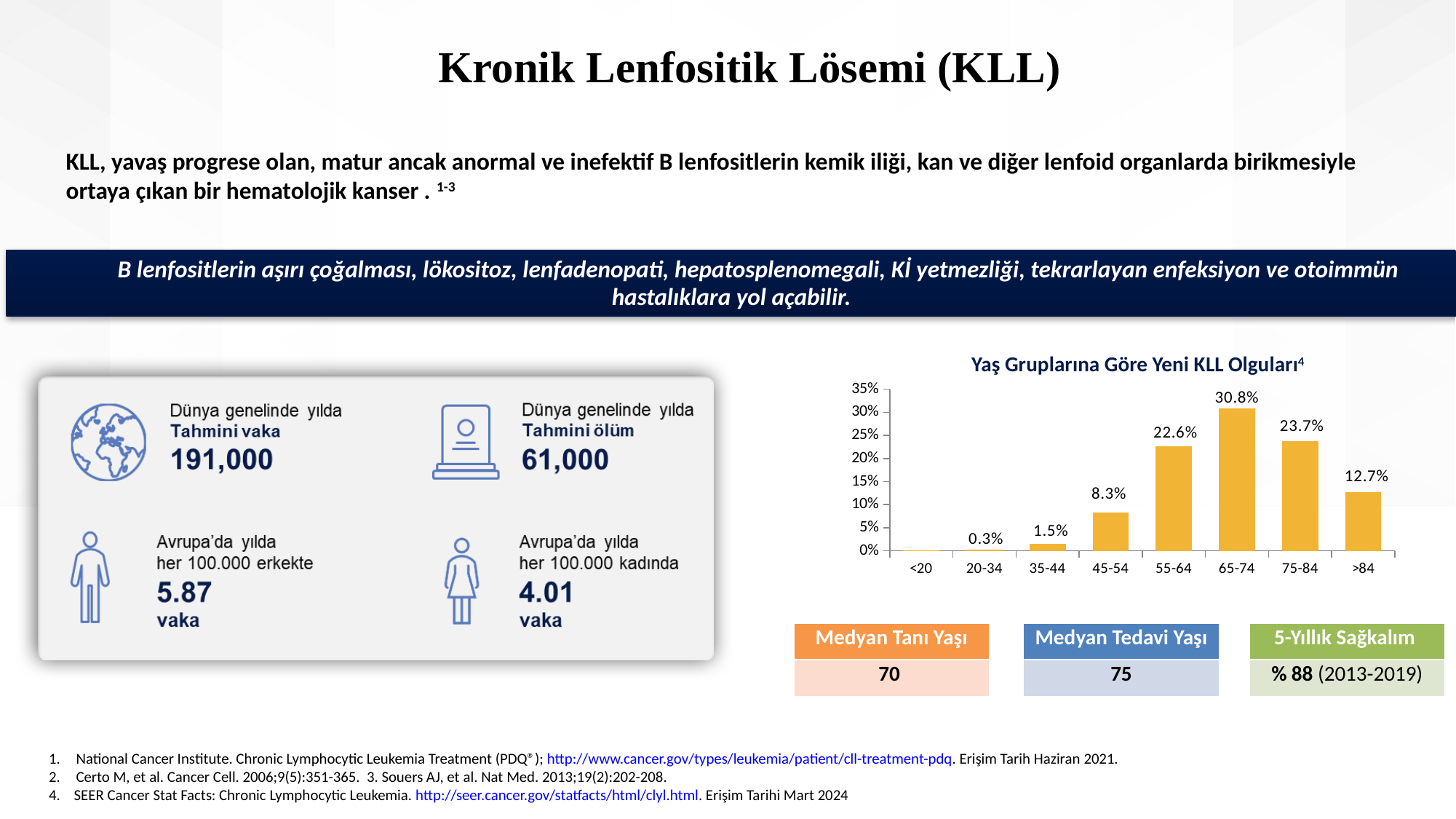
What is the value for the >84 age group in the chart? 12.7% What is the value for the 65-74 age group in the chart? 30.8% Which age group has the lowest share of new KLL cases in the chart? <20 What is the value for the 20-34 age group in the chart? 0.3% Which age group has the highest share of new KLL cases in the chart? 65-74 What is the difference between the values for the 55-64 and 45-54 age groups? 14.3% Which age group has a larger value, 75-84 or 55-64? 75-84 How many age groups are shown on the x axis of the chart? 8 What kind of chart is shown under the title "Yaş Gruplarına Göre Yeni KLL Olguları"? Bar chart What is the difference between the values for the 65-74 and 75-84 age groups? 7.1% Do the values in the chart rise or fall from the 65-74 age group to the >84 age group? Fall What is the value for the 45-54 age group in the chart? 8.3%